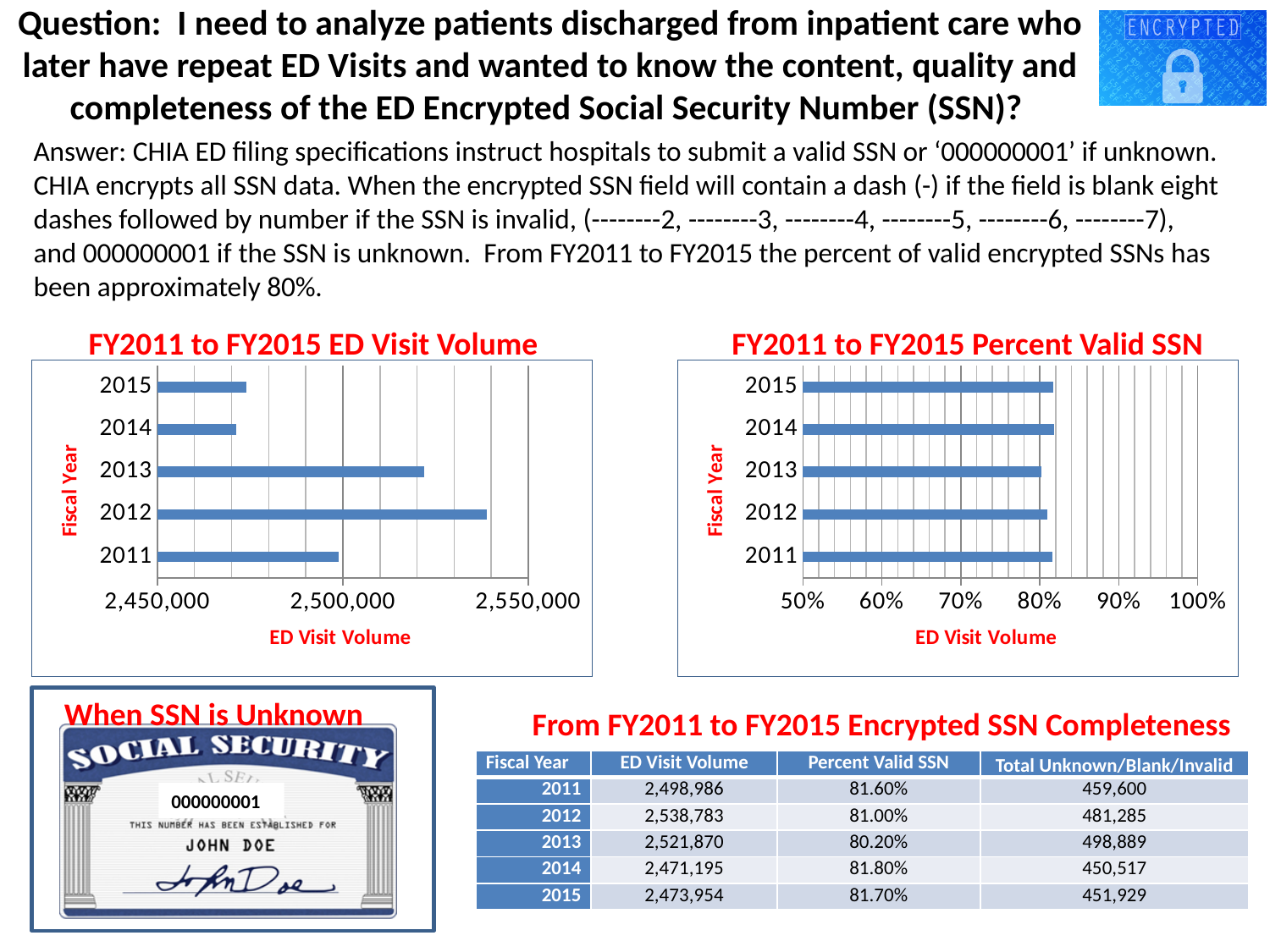
In the "FY2011 to FY2015 Percent Valid SSN" chart, is the value for 2015 greater or less than 90%? less In the "FY2011 to FY2015 ED Visit Volume" chart, which has the larger ED visit volume, 2012 or 2013? 2012 What is the label on the vertical axis of the "FY2011 to FY2015 Percent Valid SSN" chart? Fiscal Year In the "FY2011 to FY2015 ED Visit Volume" chart, is the value for 2014 greater or less than 2,500,000? less In the "FY2011 to FY2015 ED Visit Volume" chart, which fiscal year has the highest ED visit volume? 2012 What kind of chart is the "FY2011 to FY2015 ED Visit Volume" chart? Bar chart How many fiscal years are plotted in the "FY2011 to FY2015 ED Visit Volume" chart? 5 What kind of chart is the "FY2011 to FY2015 Percent Valid SSN" chart? Bar chart In the "FY2011 to FY2015 ED Visit Volume" chart, which has the larger ED visit volume, 2011 or 2014? 2011 In the "FY2011 to FY2015 Percent Valid SSN" chart, is the value for 2013 greater or less than 70%? greater